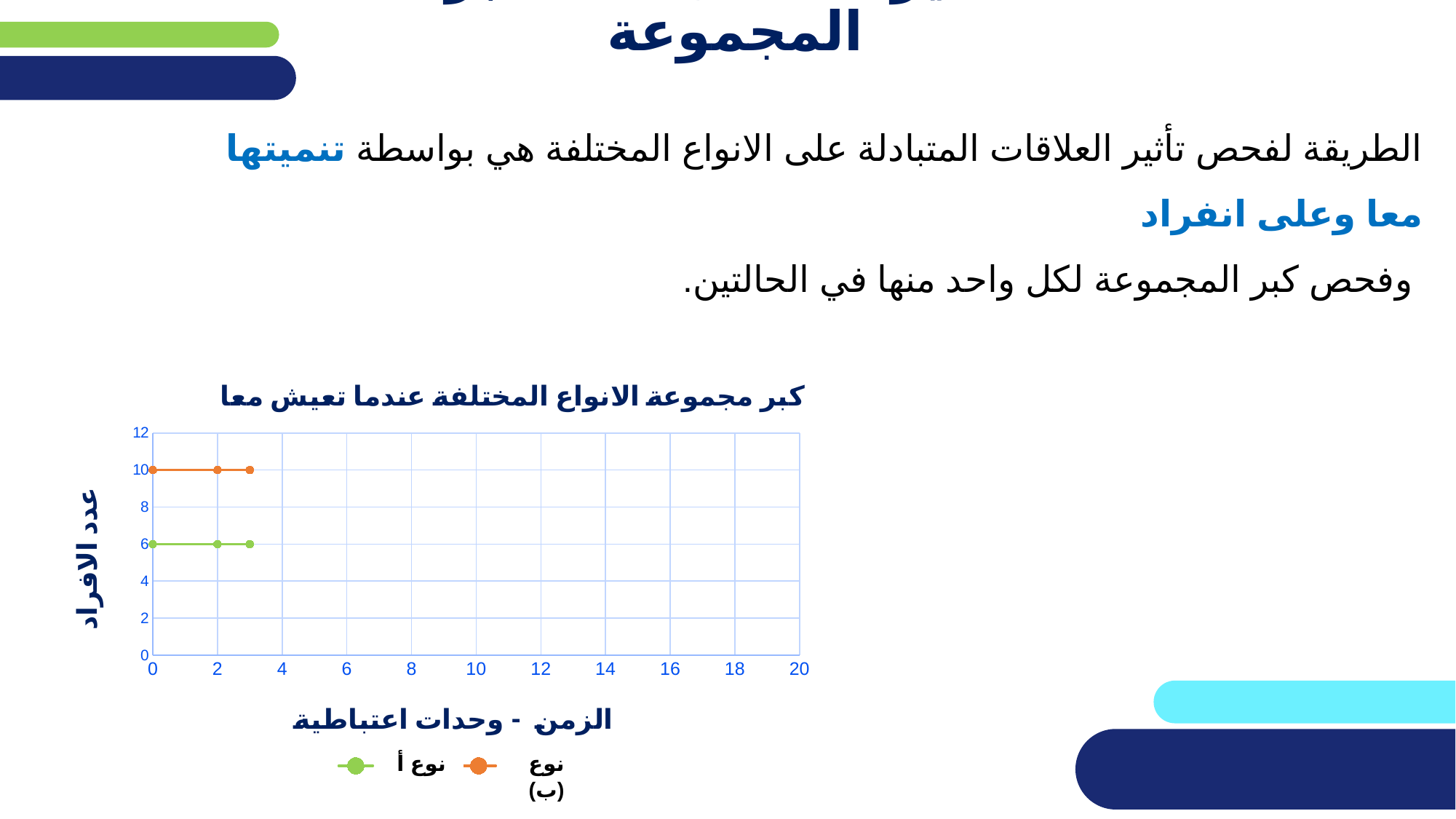
Is the value for نوع أ at time 3 greater or less than 8? less What is the value of نوع (ب) at time 2? 10 What is the value of نوع أ at time 2? 6 What kind of chart is shown on the slide? line chart What colour is the line for نوع أ? green What is the title of the chart? كبر مجموعة الانواع المختلفة عندما تعيش معا What is the difference between the value of نوع (ب) and the value of نوع أ at time 0? 4 How many series does the legend list? 2 How many data points are plotted for نوع (ب)? 3 Do the values of نوع أ rise, fall or stay constant along the x axis? stay constant Which series has the larger value at time 3, نوع أ or نوع (ب)? نوع (ب) Which series has the highest values on the chart? نوع (ب)